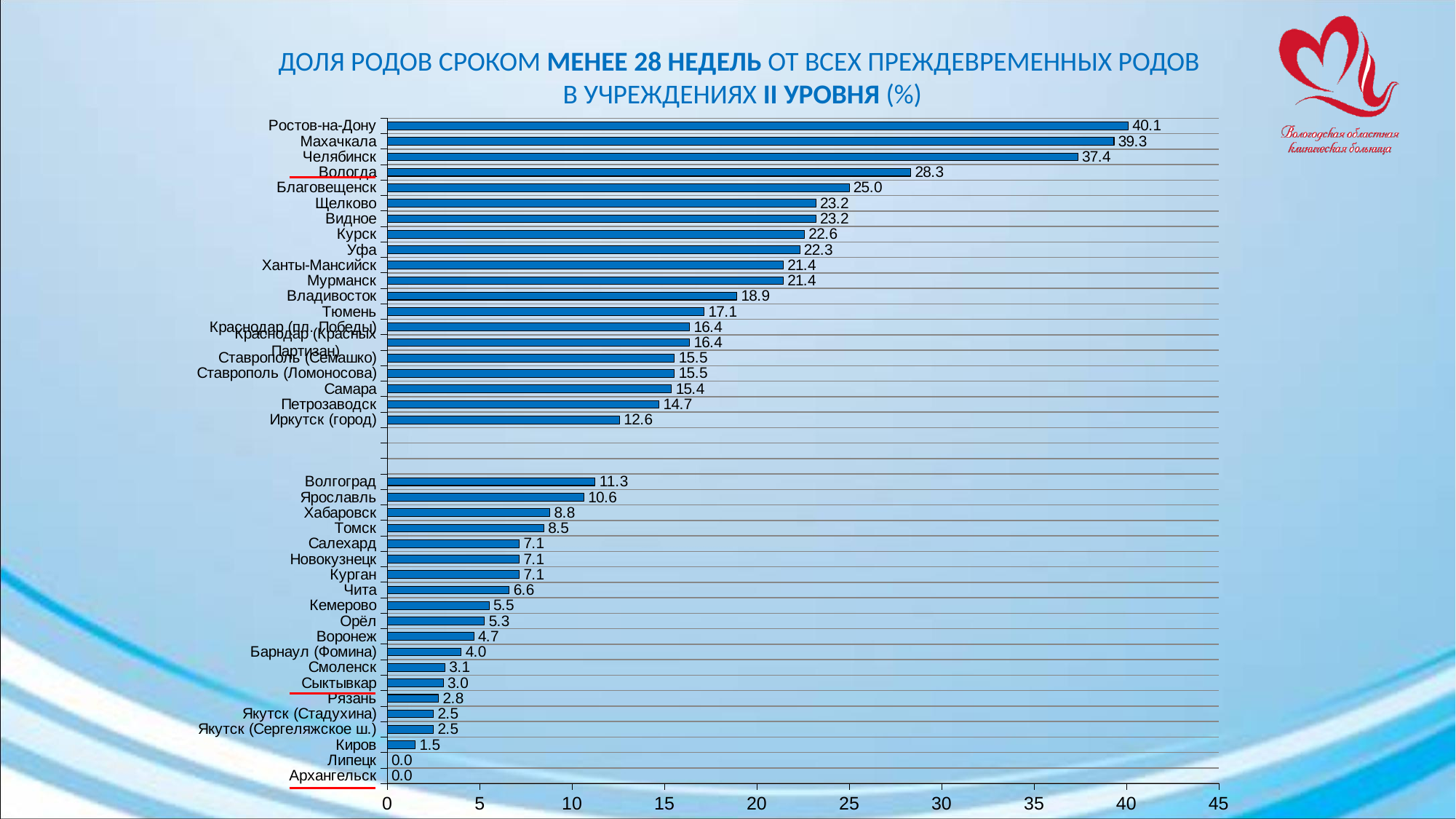
What is the value for Иркутск (город)? 12.6 Which city has the highest value? Ростов-на-Дону What kind of chart is shown on the slide? bar chart How many cities have a value of 0.0? 2 How many cities are listed on the chart? 40 What is the maximum value shown on the horizontal axis? 45 What is the value for Вологда? 28.3 Which has the larger value, Махачкала or Челябинск? Махачкала What is the value for Сыктывкар? 3.0 What is the difference between the values for Ростов-на-Дону and Вологда? 11.8 Is the value for Благовещенск greater or less than 20? greater What is the value for Ростов-на-Дону? 40.1